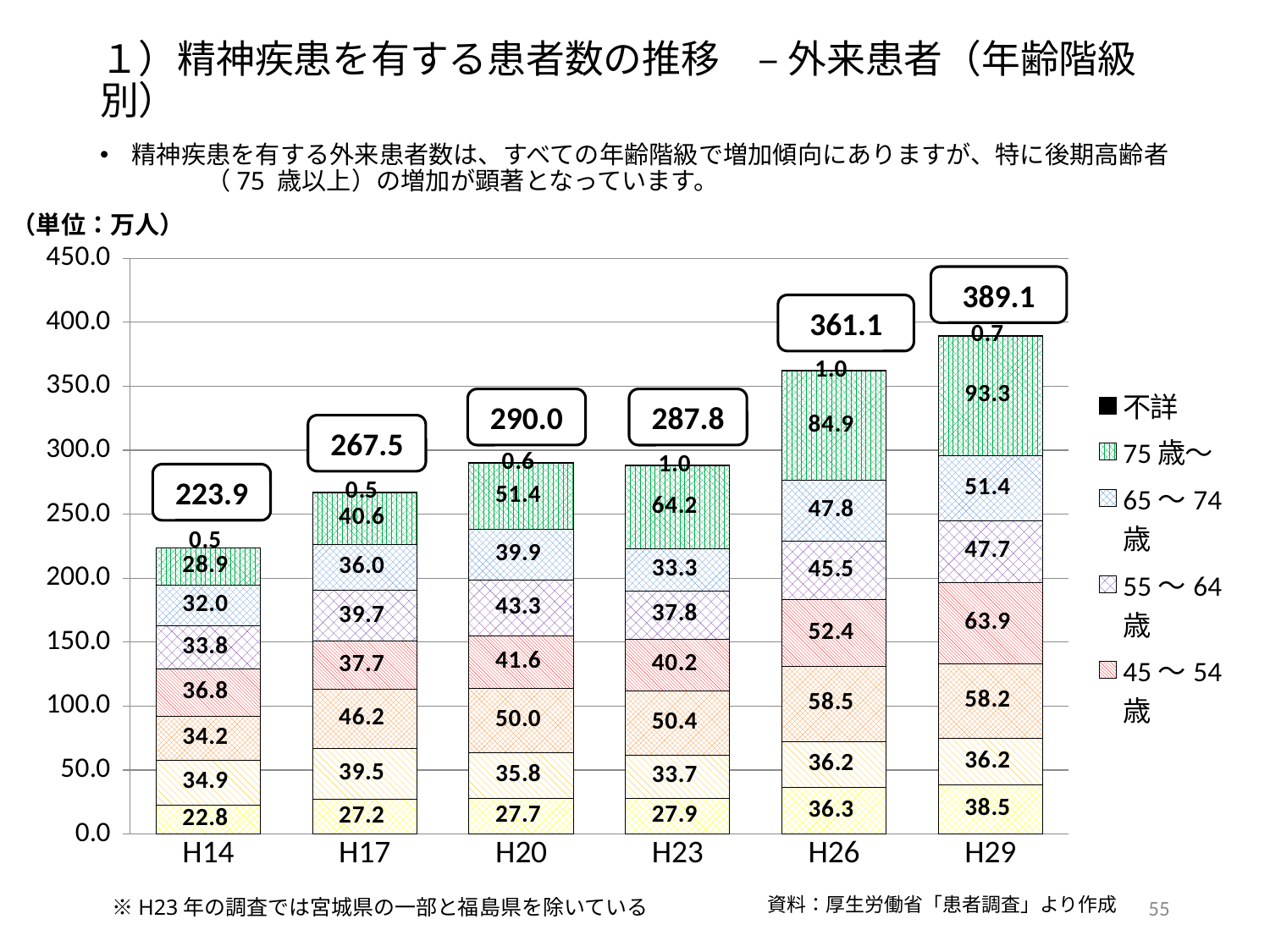
What is the difference between the total for H29 and the total for H26? 28.0 What is the total number of outpatients shown above the H29 bar? 389.1 What is the value of the 65〜74歳 segment for H17? 36.0 Is the total for H23 greater or less than 300.0? less Does the 75歳〜 segment rise or fall from H14 to H29? rises What is the value of the 75歳〜 segment for H26? 84.9 What kind of chart is shown on the slide? stacked bar chart What unit is stated for the values in the chart? 万人 Which year has the highest total number of outpatients? H29 How many survey years (categories) are shown on the x axis? 6 Which is larger, the 75歳〜 segment for H23 or for H20? H23 Which year has the lowest total number of outpatients? H14